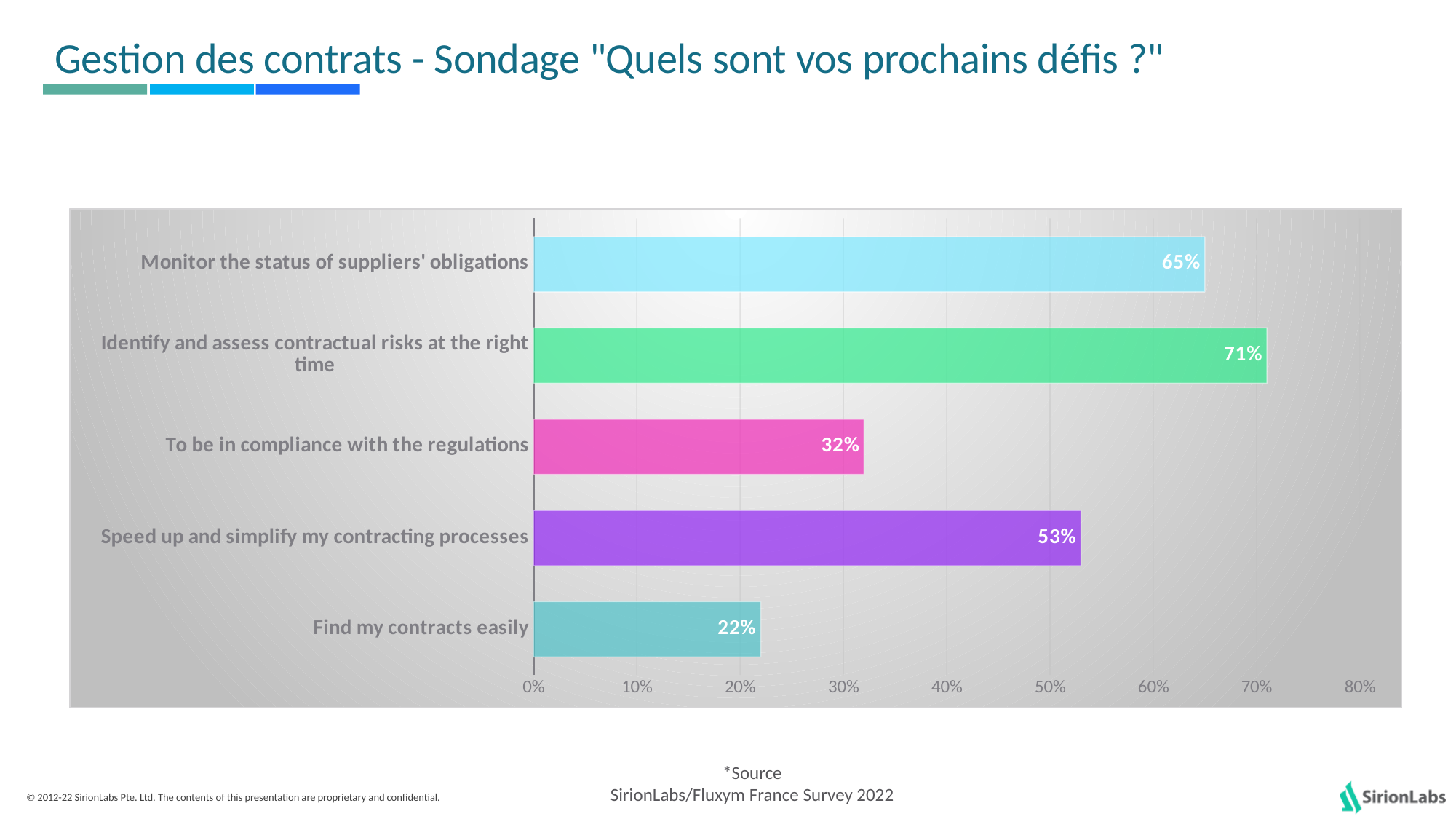
Which is larger: the value for "To be in compliance with the regulations" or the value for "Find my contracts easily"? To be in compliance with the regulations What is the value for "Speed up and simplify my contracting processes"? 53% What is the value for "Monitor the status of suppliers' obligations"? 65% What is the maximum value shown on the horizontal axis? 80% What kind of chart is shown on the slide? Bar chart What is the difference between the values for "Identify and assess contractual risks at the right time" and "Monitor the status of suppliers' obligations"? 6% Is the value for "Speed up and simplify my contracting processes" greater or less than 50%? greater Which category has the lowest value? Find my contracts easily Which category has the highest value? Identify and assess contractual risks at the right time What is the difference between the values for "Speed up and simplify my contracting processes" and "To be in compliance with the regulations"? 21% What is the value for "Find my contracts easily"? 22% How many categories are shown in the chart? 5